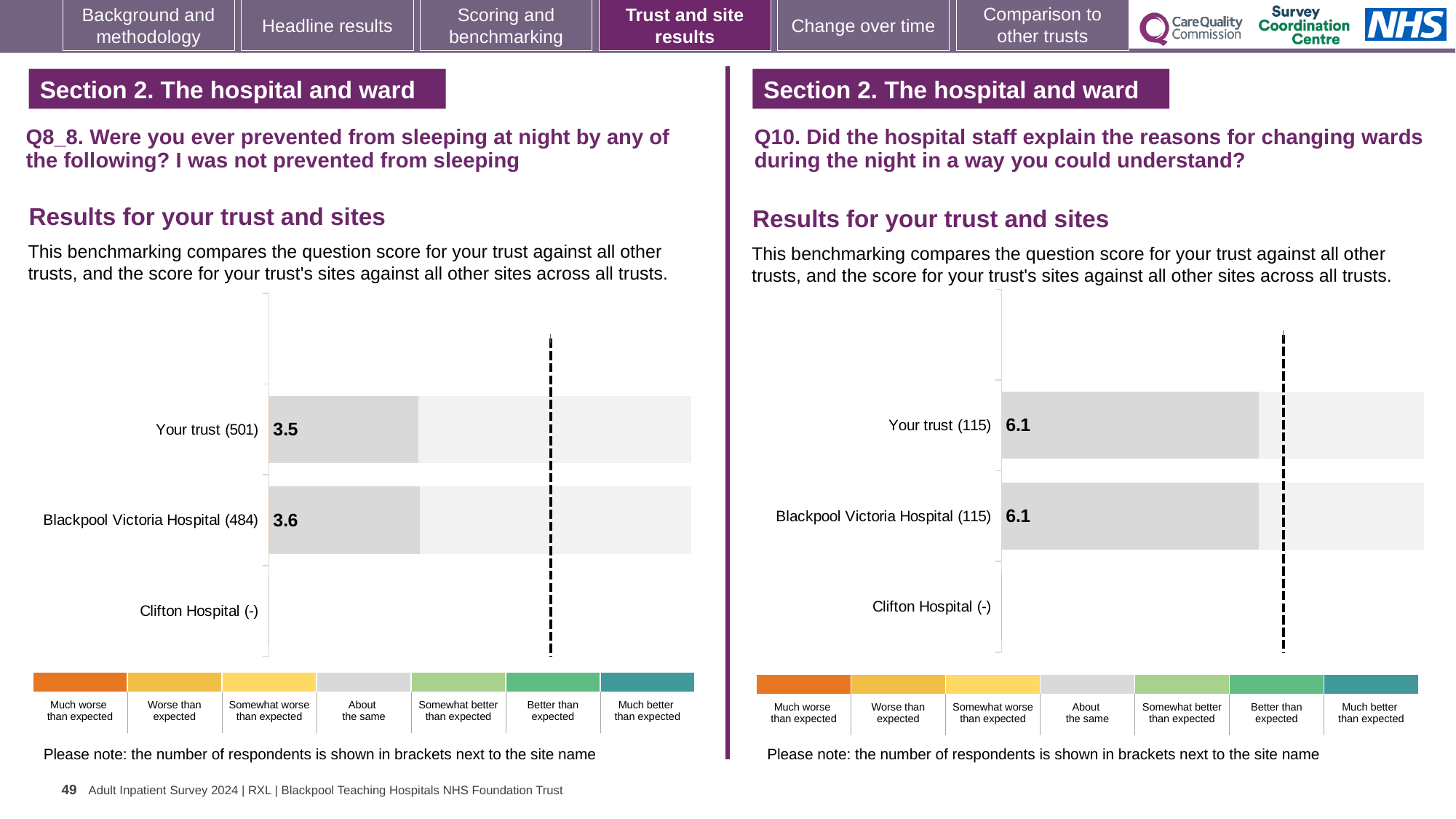
In the right chart (Q10), what is the score for Your trust (115)? 6.1 How many site/trust categories are listed on the left chart (Q8_8)? 3 What type of chart is used on the left (Q8_8)? Bar chart How many site/trust categories are listed on the right chart (Q10)? 3 In the left chart (Q8_8), which has the higher score: Your trust or Blackpool Victoria Hospital? Blackpool Victoria Hospital In the left chart (Q8_8), how many respondents are shown for Blackpool Victoria Hospital? 484 In the right chart (Q10), what is the score for Blackpool Victoria Hospital (115)? 6.1 In the left chart (Q8_8), what is the score for Blackpool Victoria Hospital (484)? 3.6 In the left chart (Q8_8), which category has the lowest plotted score? Your trust (501) In the left chart (Q8_8), what is the score for Your trust (501)? 3.5 In the left chart (Q8_8), what is the difference between the scores for Blackpool Victoria Hospital and Your trust? 0.1 In the right chart (Q10), how many respondents are shown for Your trust? 115